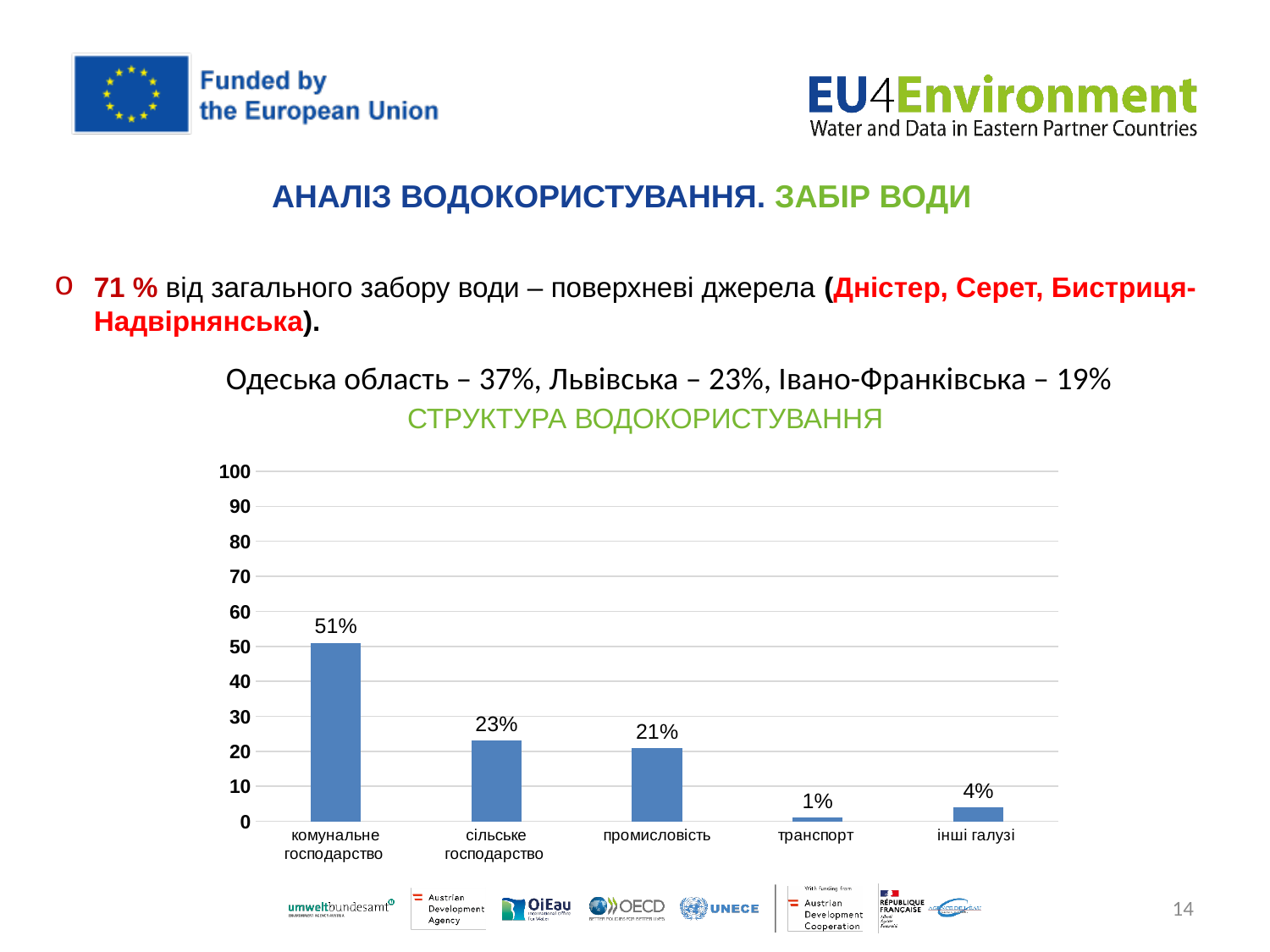
What kind of chart is shown? bar chart How many categories are shown on the x axis? 5 What is the value for інші галузі? 4% Which category has the lowest value? транспорт Which is larger, the value for промисловість or the value for інші галузі? промисловість What is the difference between the values for комунальне господарство and сільське господарство? 28% What is the value for сільське господарство? 23% What is the title of the chart? СТРУКТУРА ВОДОКОРИСТУВАННЯ What is the value for промисловість? 21% What is the value for комунальне господарство? 51% What is the value for транспорт? 1% Which category has the highest value? комунальне господарство